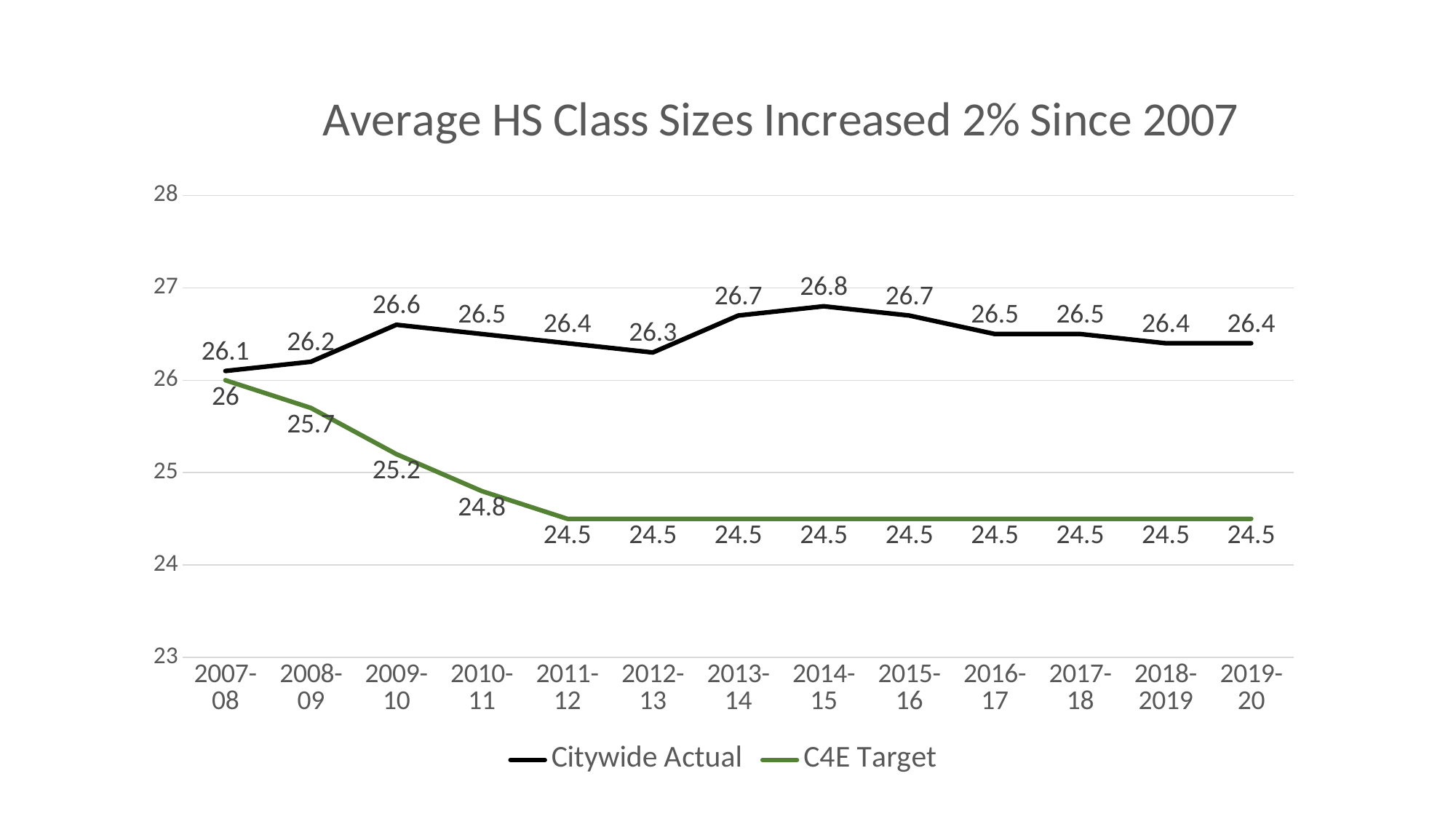
Which is larger in 2008-09, the Citywide Actual value or the C4E Target value? Citywide Actual How many school years are shown on the x axis? 13 What kind of chart is shown on the slide? Line chart In which school year is the Citywide Actual value highest? 2014-15 Does the C4E Target series rise or fall from 2007-08 to 2011-12? Fall What is the C4E Target value for 2009-10? 25.2 How many series does the legend list? 2 What is the Citywide Actual value for 2007-08? 26.1 In which school year is the Citywide Actual value lowest? 2007-08 What is the Citywide Actual value for 2014-15? 26.8 What is the difference between the Citywide Actual and C4E Target values in 2019-20? 1.9 What is the title of the chart? Average HS Class Sizes Increased 2% Since 2007